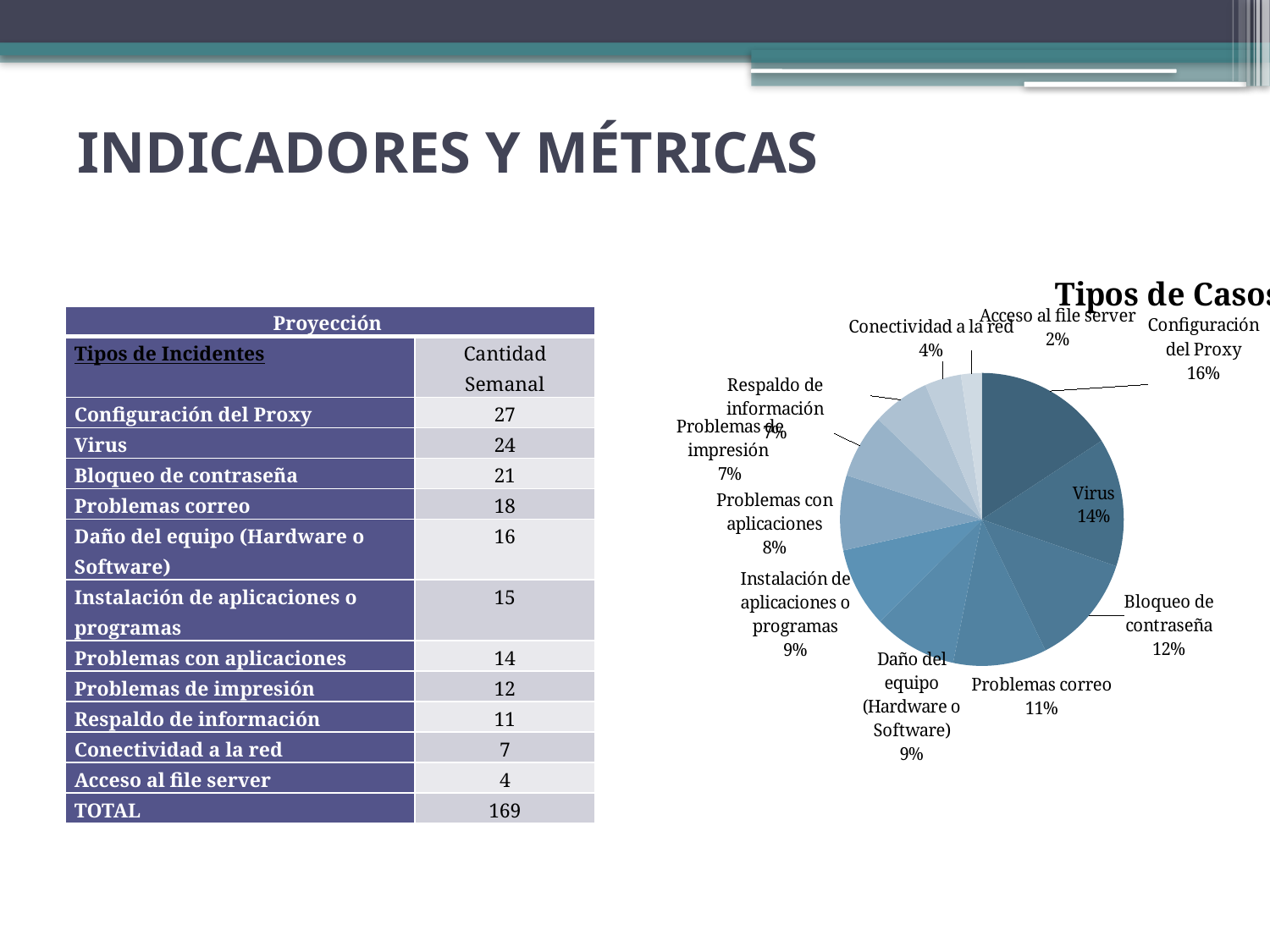
What kind of chart is shown on the slide? pie chart How many slices does the pie chart have? 11 Which slice of the pie chart is the largest? Configuración del Proxy In the pie chart, what share does Problemas correo have? 11% What is the title of the pie chart? Tipos de Casos In the pie chart, what share does Configuración del Proxy have? 16% Which slice of the pie chart is the smallest? Acceso al file server In the pie chart, which is larger: Virus or Problemas correo? Virus In the pie chart, what is the difference in percentage points between Configuración del Proxy and Conectividad a la red? 12 In the pie chart, what share does Virus have? 14%